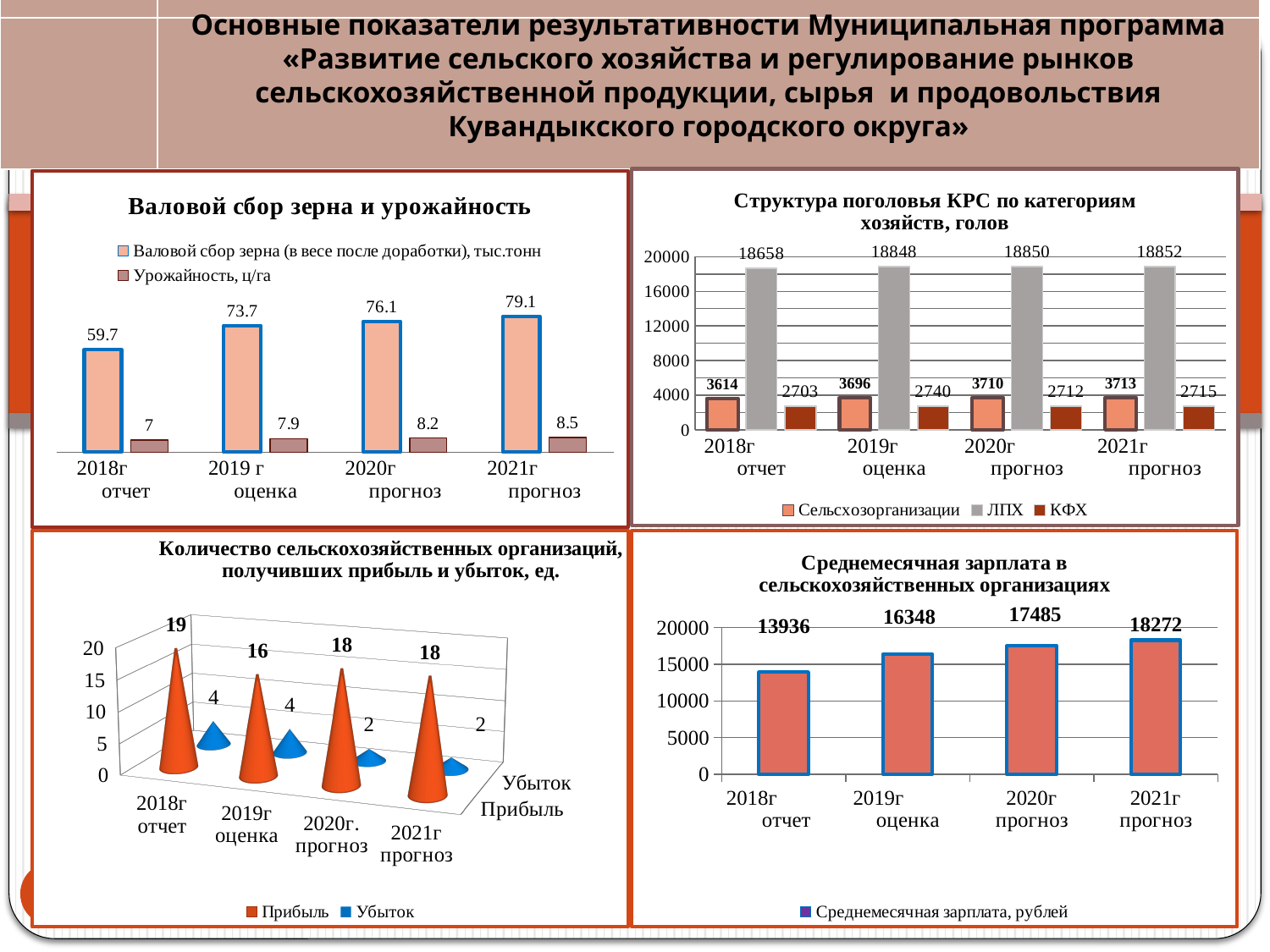
In the chart 'Структура поголовья КРС по категориям хозяйств, голов', which series has the highest values? ЛПХ In the chart 'Среднемесячная зарплата в сельскохозяйственных организациях', what is the difference between the 2021г прогноз and 2018г отчет values? 4336 In the chart 'Валовой сбор зерна и урожайность', how many series does the legend list? 2 In the chart 'Количество сельскохозяйственных организаций, получивших прибыль и убыток, ед.', what is the value of Прибыль for 2018г отчет? 19 In the chart 'Валовой сбор зерна и урожайность', what is the value of 'Валовой сбор зерна' for 2019 г оценка? 73.7 In the chart 'Количество сельскохозяйственных организаций, получивших прибыль и убыток, ед.', what is the value of Убыток for 2021г прогноз? 2 In the chart 'Валовой сбор зерна и урожайность', what is the value of 'Урожайность, ц/га' for 2021г прогноз? 8.5 In the chart 'Структура поголовья КРС по категориям хозяйств, голов', what is the difference between Сельскохозорганизации and КФХ in 2018г отчет? 911 In the chart 'Валовой сбор зерна и урожайность', does the value of 'Валовой сбор зерна' rise or fall from 2018г to 2021г? rise In the chart 'Структура поголовья КРС по категориям хозяйств, голов', how many series does the legend list? 3 In the chart 'Среднемесячная зарплата в сельскохозяйственных организациях', what is the value for 2020г прогноз? 17485 In the chart 'Структура поголовья КРС по категориям хозяйств, голов', what is the value for ЛПХ in 2020г прогноз? 18850